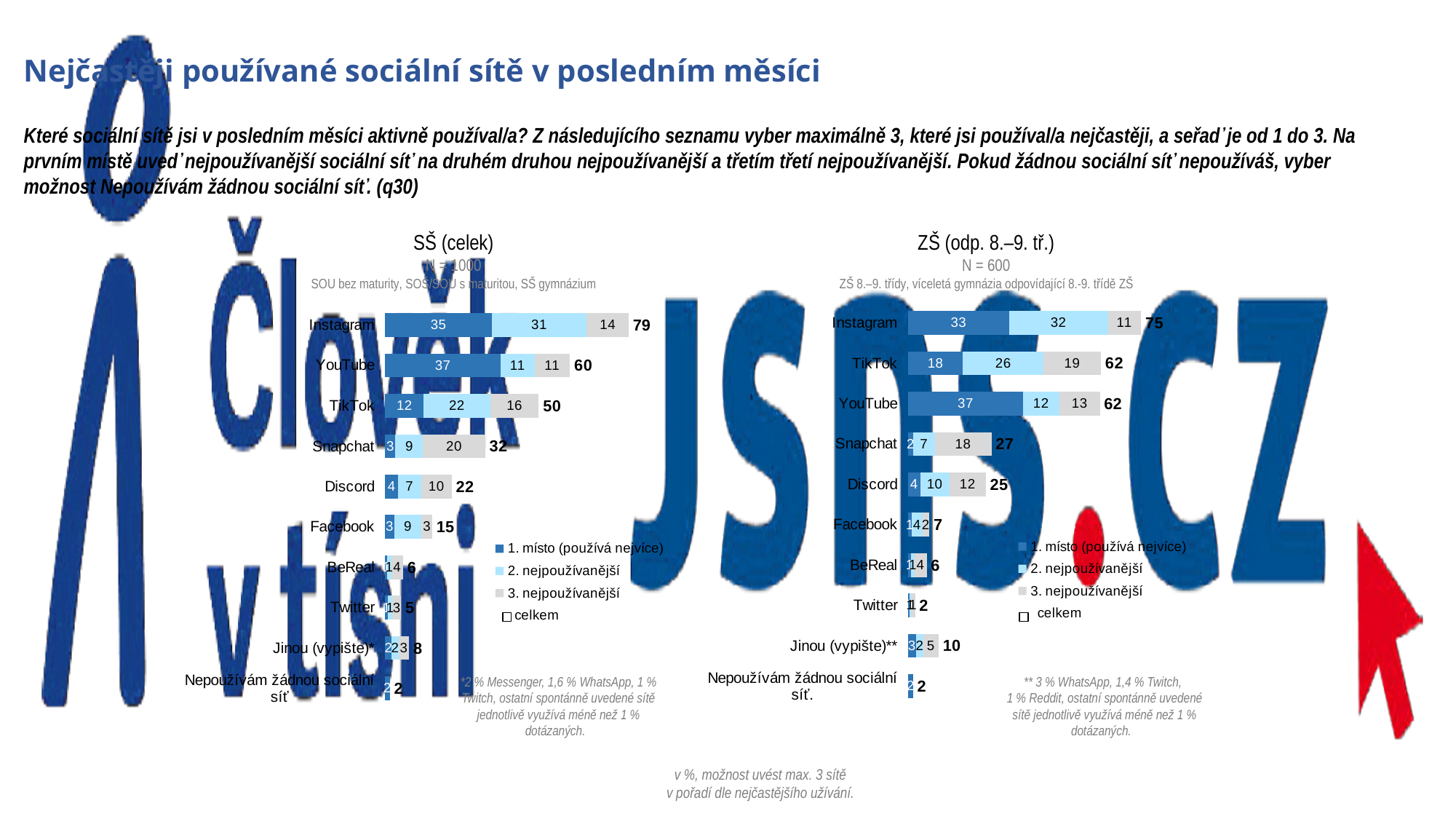
In the SŠ (celek) chart, which has a larger total value, TikTok or Snapchat? TikTok What kind of chart is the SŠ (celek) chart? Stacked bar chart In the ZŠ (odp. 8.–9. tř.) chart, what is the sum of the three segments for Discord (4, 10 and 12)? 26 In the ZŠ (odp. 8.–9. tř.) chart, which social network has the highest total (celkem) value? Instagram In the SŠ (celek) chart, what is the difference between the total values for Instagram and YouTube? 19 In the ZŠ (odp. 8.–9. tř.) chart, what is the '2. nejpoužívanější' value for TikTok? 26 What is the sample size (N) shown for the ZŠ (odp. 8.–9. tř.) chart? N = 600 In the SŠ (celek) chart, what is the '1. místo (používá nejvíce)' value for YouTube? 37 How many entries does the legend of the ZŠ (odp. 8.–9. tř.) chart list? 4 In the ZŠ (odp. 8.–9. tř.) chart, what is the total value for Snapchat? 27 In the SŠ (celek) chart, what is the total (celkem) value for Instagram? 79 How many categories (social networks/options) are listed in the SŠ (celek) chart? 10